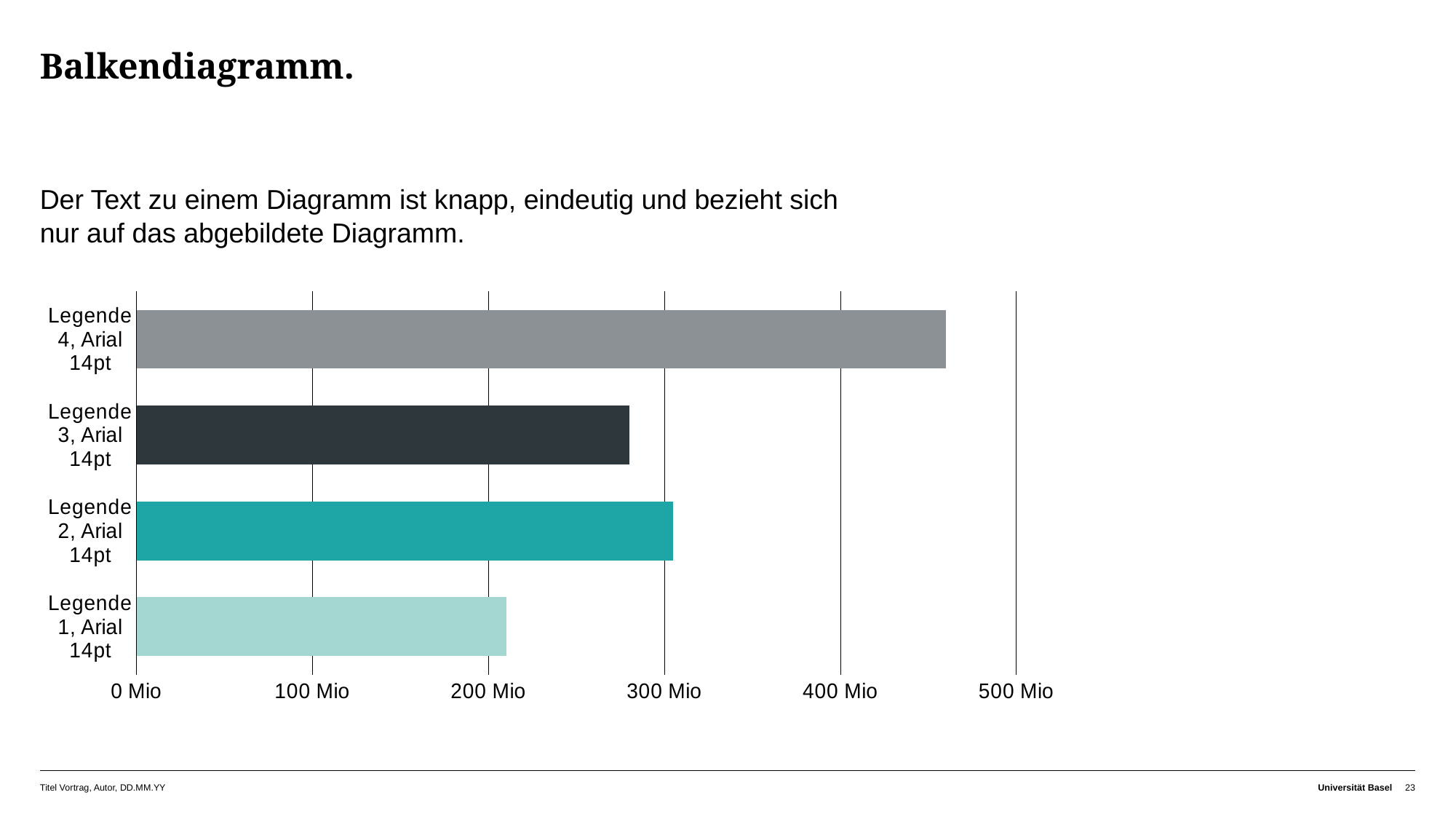
Is the value for Legende 4, Arial 14pt greater or less than 400 Mio? greater What kind of chart is shown on the slide? bar chart Is the value for Legende 3, Arial 14pt greater or less than 300 Mio? less How many bars does the chart show? 4 Which category has the lowest value? Legende 1, Arial 14pt Is the value for Legende 1, Arial 14pt greater or less than 300 Mio? less Which category has the highest value? Legende 4, Arial 14pt Which is larger, the value for Legende 1, Arial 14pt or the value for Legende 4, Arial 14pt? Legende 4, Arial 14pt What is the title of the slide containing the chart? Balkendiagramm. Which is larger, the value for Legende 2, Arial 14pt or the value for Legende 3, Arial 14pt? Legende 2, Arial 14pt